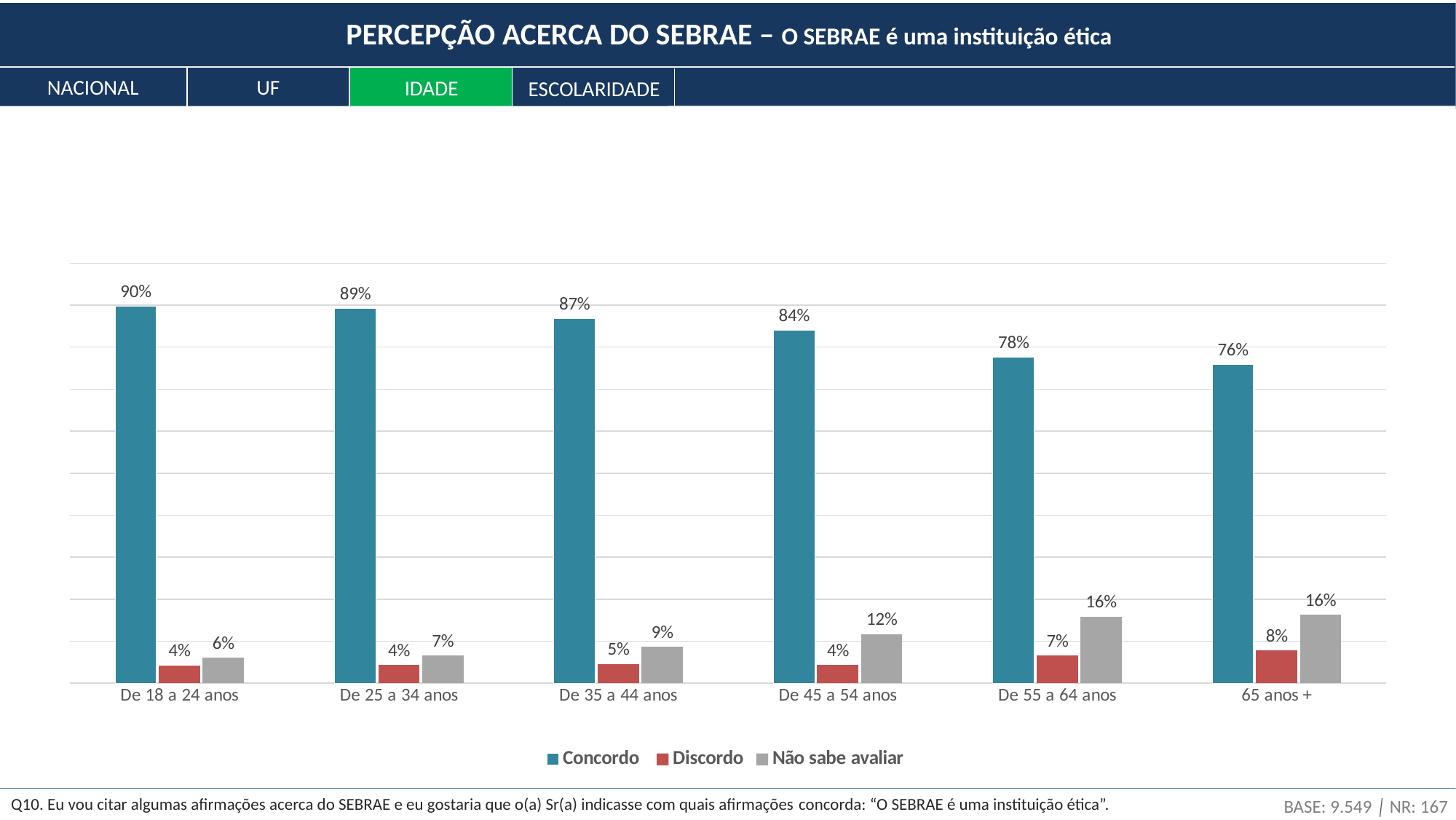
Which age group has the lowest Concordo value? 65 anos + Which legend entry is shown in red? Discordo Do the Concordo values rise or fall as age increases along the x axis? Fall What is the Concordo value for De 18 a 24 anos? 90% How many series does the legend list? 3 What kind of chart is shown on the slide? Bar chart Which is larger: the Não sabe avaliar value for De 35 a 44 anos or for De 55 a 64 anos? De 55 a 64 anos What is the Discordo value for 65 anos +? 8% How many age groups are shown on the x axis? 6 What is the Não sabe avaliar value for De 45 a 54 anos? 12% What is the difference between the Concordo values for De 18 a 24 anos and 65 anos +? 14% Which age group has the highest Concordo value? De 18 a 24 anos